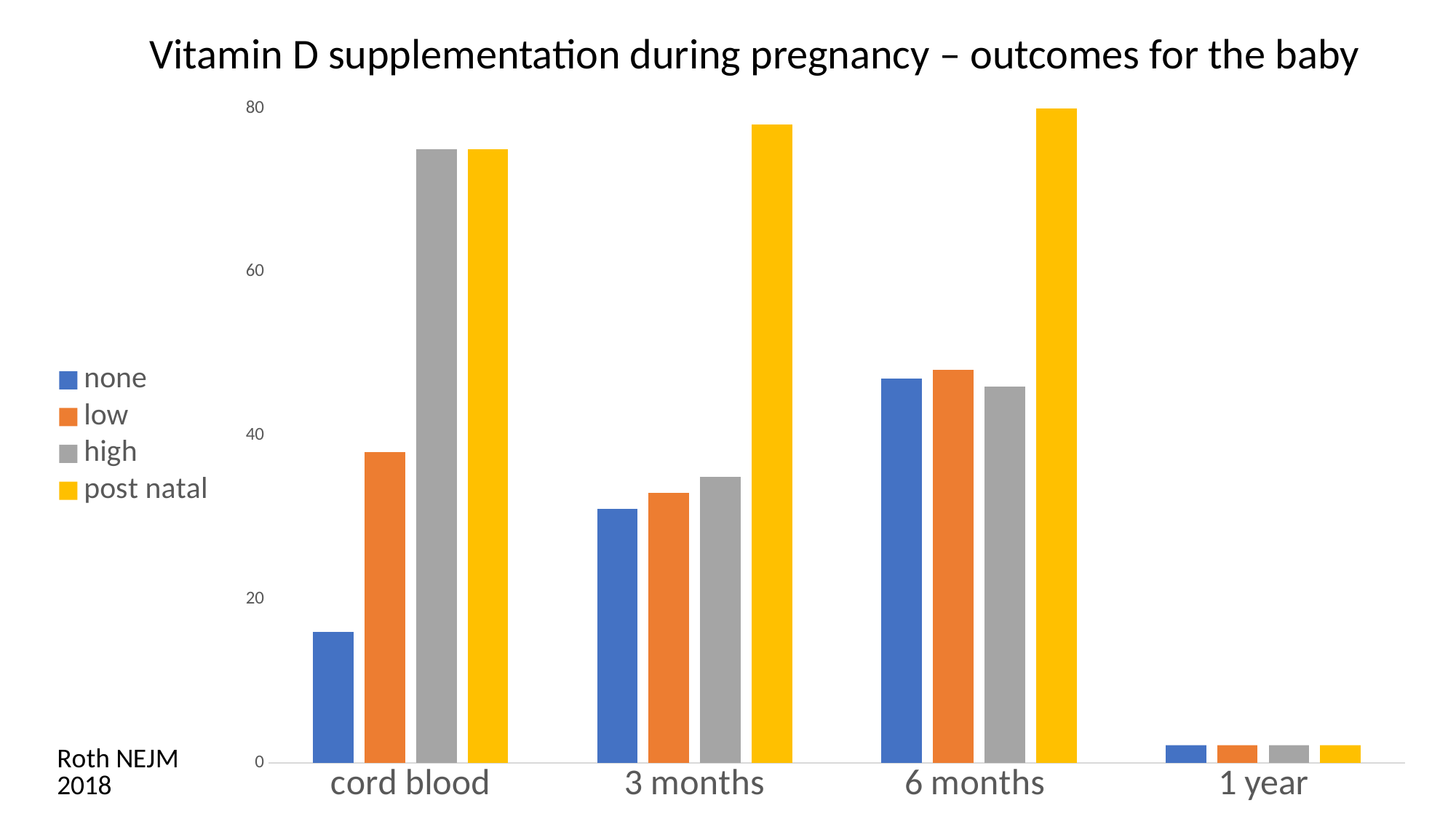
How many series does the legend list? 4 In which category is the none bar lowest? 1 year At cord blood, which is larger: high or none? high What kind of chart is shown on the slide? bar chart Is the value for post natal at 6 months greater or less than 60? greater At 3 months, which is larger: post natal or none? post natal What is the title of the chart? Vitamin D supplementation during pregnancy – outcomes for the baby Is the value for low at cord blood greater or less than 20? greater Does the none series rise or fall from cord blood to 6 months? rise Is the value for none at cord blood greater or less than 20? less How many categories are shown on the x axis? 4 In which category is the post natal bar highest? 6 months